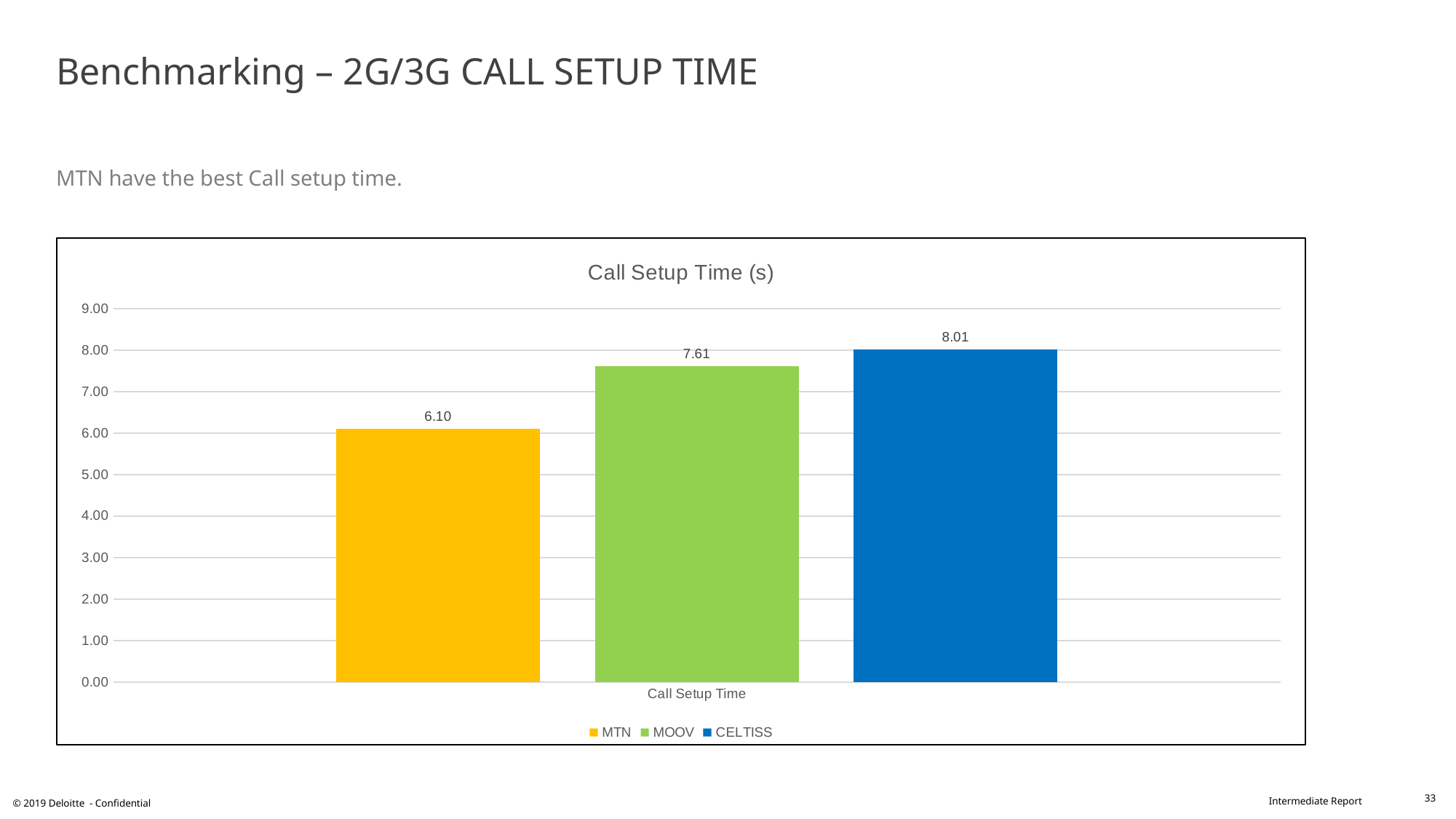
Which operator has the lowest call setup time? MTN What is the difference between the call setup times of CELTISS and MTN? 1.91 Which has a larger call setup time, MOOV or CELTISS? CELTISS What is the call setup time for CELTISS? 8.01 What kind of chart is shown on the slide? Bar chart Which operator has the highest call setup time? CELTISS What is the call setup time for MOOV? 7.61 Is the call setup time for MOOV greater or less than 7.00? greater What is the call setup time for MTN? 6.10 How many series does the legend list? 3 What is the title of the chart? Call Setup Time (s) What is the difference between the call setup times of MOOV and MTN? 1.51